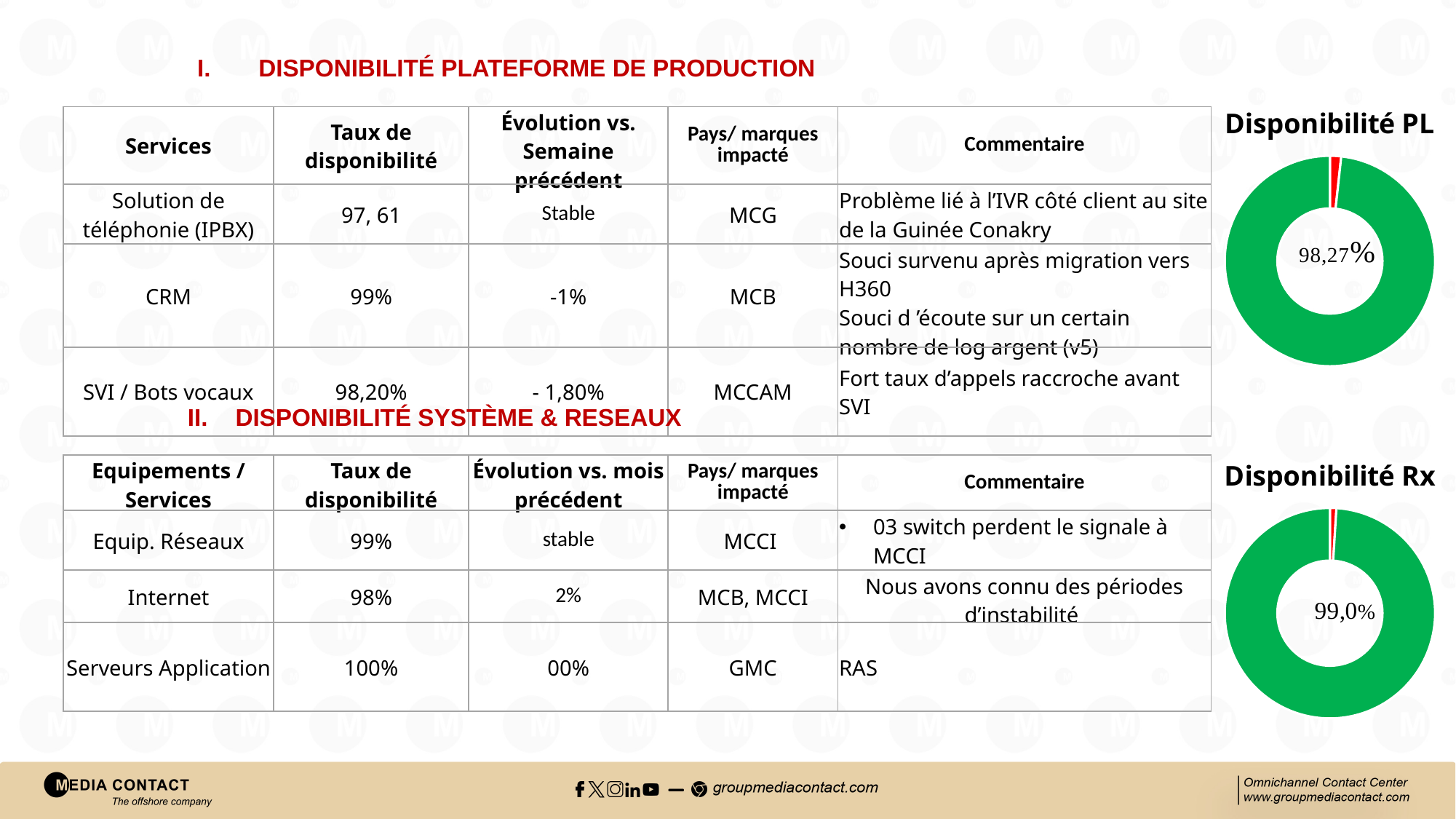
How many slices does the 'Disponibilité PL' donut chart have? 2 How many slices does the 'Disponibilité Rx' donut chart have? 2 In the 'Disponibilité PL' chart, what value is printed in the centre of the donut? 98,27% What kind of chart is the 'Disponibilité Rx' chart? Donut (pie) chart What kind of chart is the 'Disponibilité PL' chart? Donut (pie) chart In the 'Disponibilité PL' chart, which slice is larger, the green one or the red one? The green one What colour is the large slice in the 'Disponibilité Rx' chart? Green What is the title of the donut chart at the top right of the slide? Disponibilité PL What is the difference between the value shown in the 'Disponibilité Rx' chart and the value shown in the 'Disponibilité PL' chart? 0,73% Which chart shows the higher availability value, 'Disponibilité PL' or 'Disponibilité Rx'? Disponibilité Rx In the 'Disponibilité Rx' chart, what value is printed in the centre of the donut? 99,0% In the 'Disponibilité Rx' chart, which slice is the smallest? The red slice